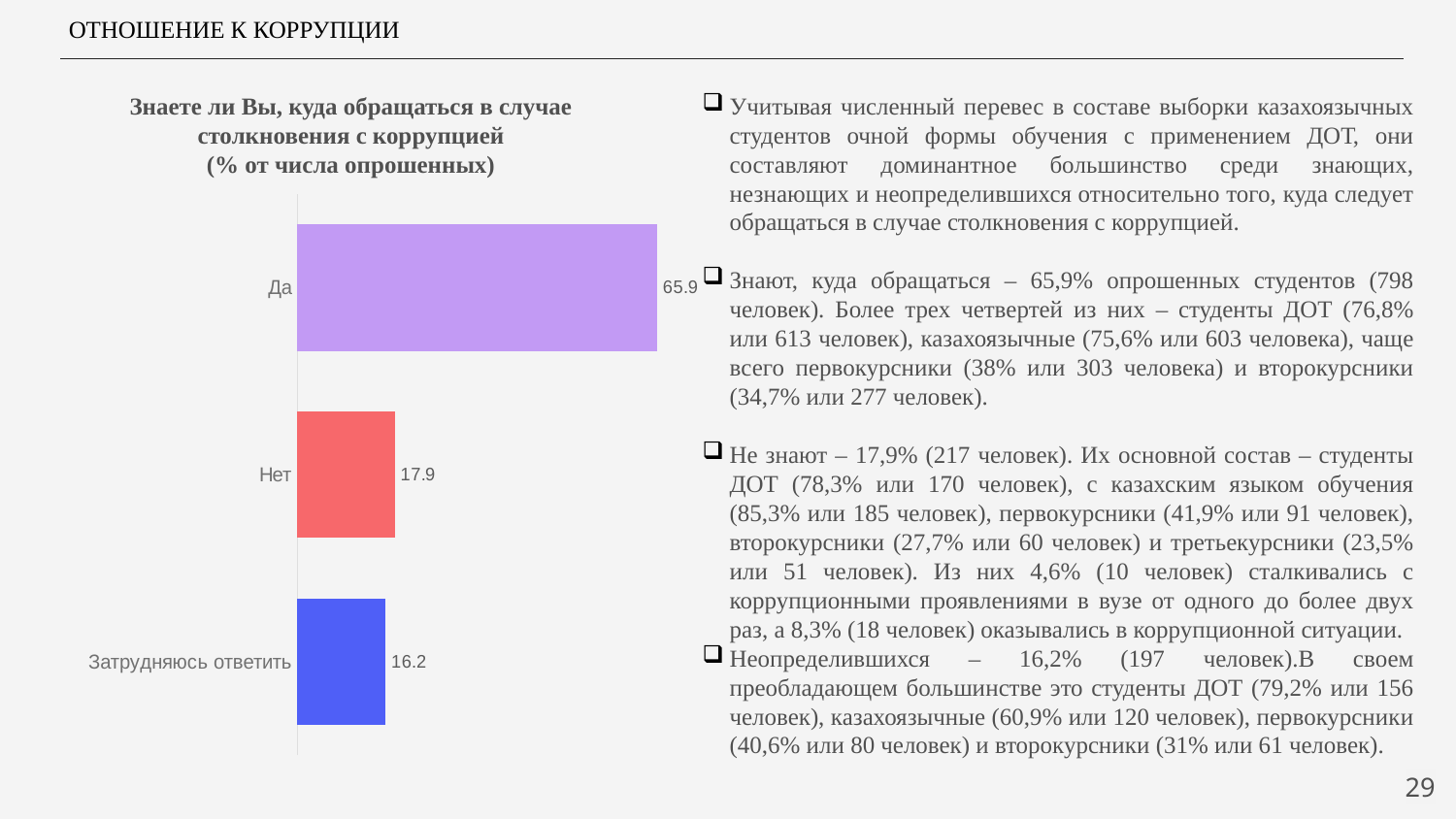
Which category has the lowest value in the chart? Затрудняюсь ответить What is the value for "Нет" in the chart? 17.9 Which is larger, the value for "Да" or the value for "Затрудняюсь ответить"? Да What is the difference between the values for "Да" and "Нет"? 48.0 What kind of chart is shown on the slide? Bar chart What is the value for "Затрудняюсь ответить" in the chart? 16.2 What is the title of the chart? Знаете ли Вы, куда обращаться в случае столкновения с коррупцией (% от числа опрошенных) What is the value for "Да" in the chart? 65.9 What colour is the bar for "Нет"? Red Which category has the highest value in the chart? Да What is the difference between the values for "Нет" and "Затрудняюсь ответить"? 1.7 How many categories are shown in the chart? 3